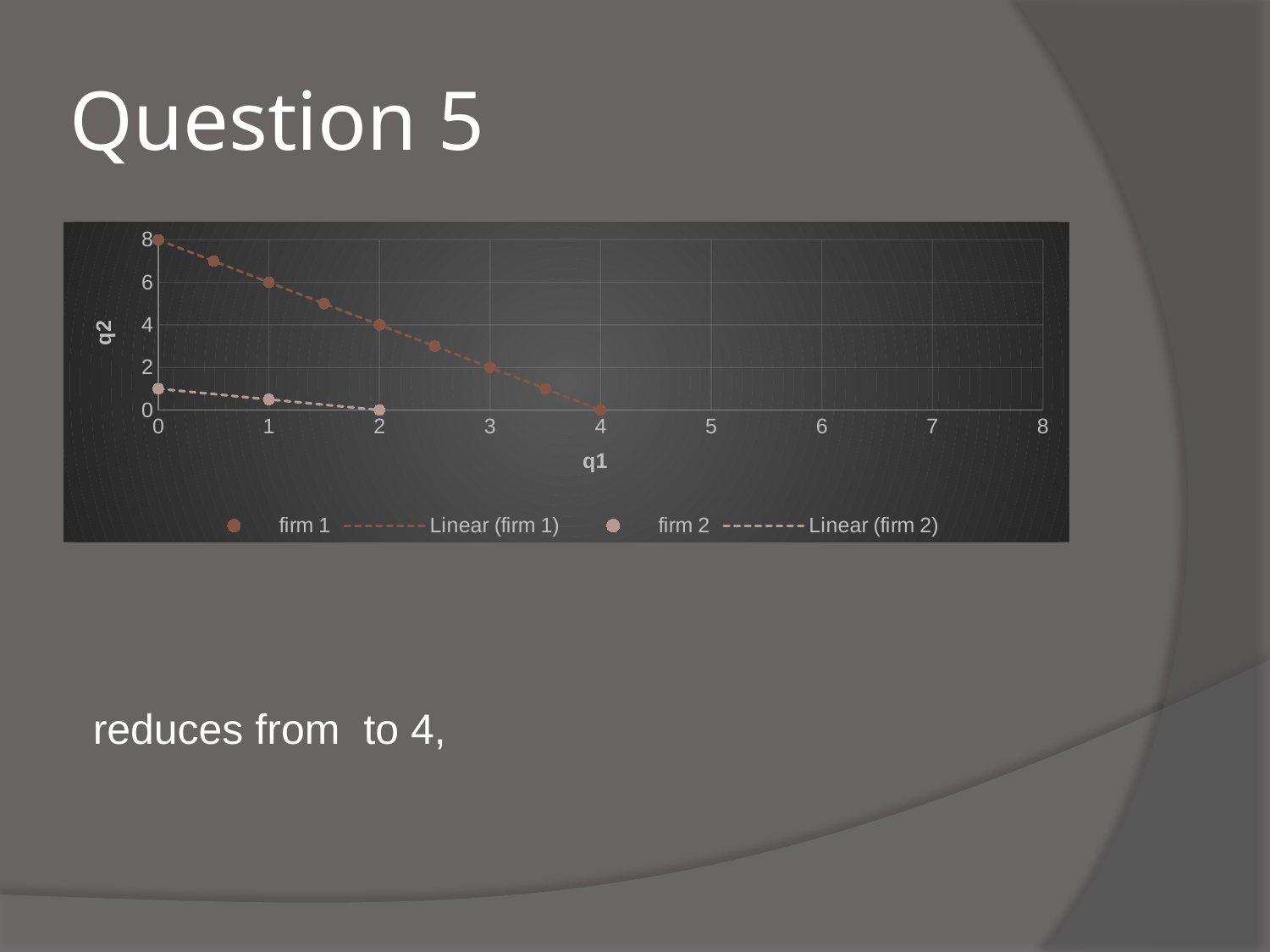
At q1 = 1, which series has the larger q2 value, firm 1 or firm 2? firm 1 What is the q2 value of the firm 1 series at q1 = 0? 8 Do the q2 values of the firm 1 series rise or fall as q1 increases? fall How many data points are plotted for the firm 2 series? 3 How many data points are plotted for the firm 1 series? 9 What is the q2 value of the firm 1 series at q1 = 2? 4 How many entries does the chart legend list? 4 What is the q2 value of the firm 1 series at q1 = 4? 0 What is the title of the horizontal axis of the chart? q1 What is the q2 value of the firm 2 series at q1 = 2? 0 What kind of chart is shown on the slide? scatter chart Is the q2 value of the firm 2 series at q1 = 0 greater or less than 2? less